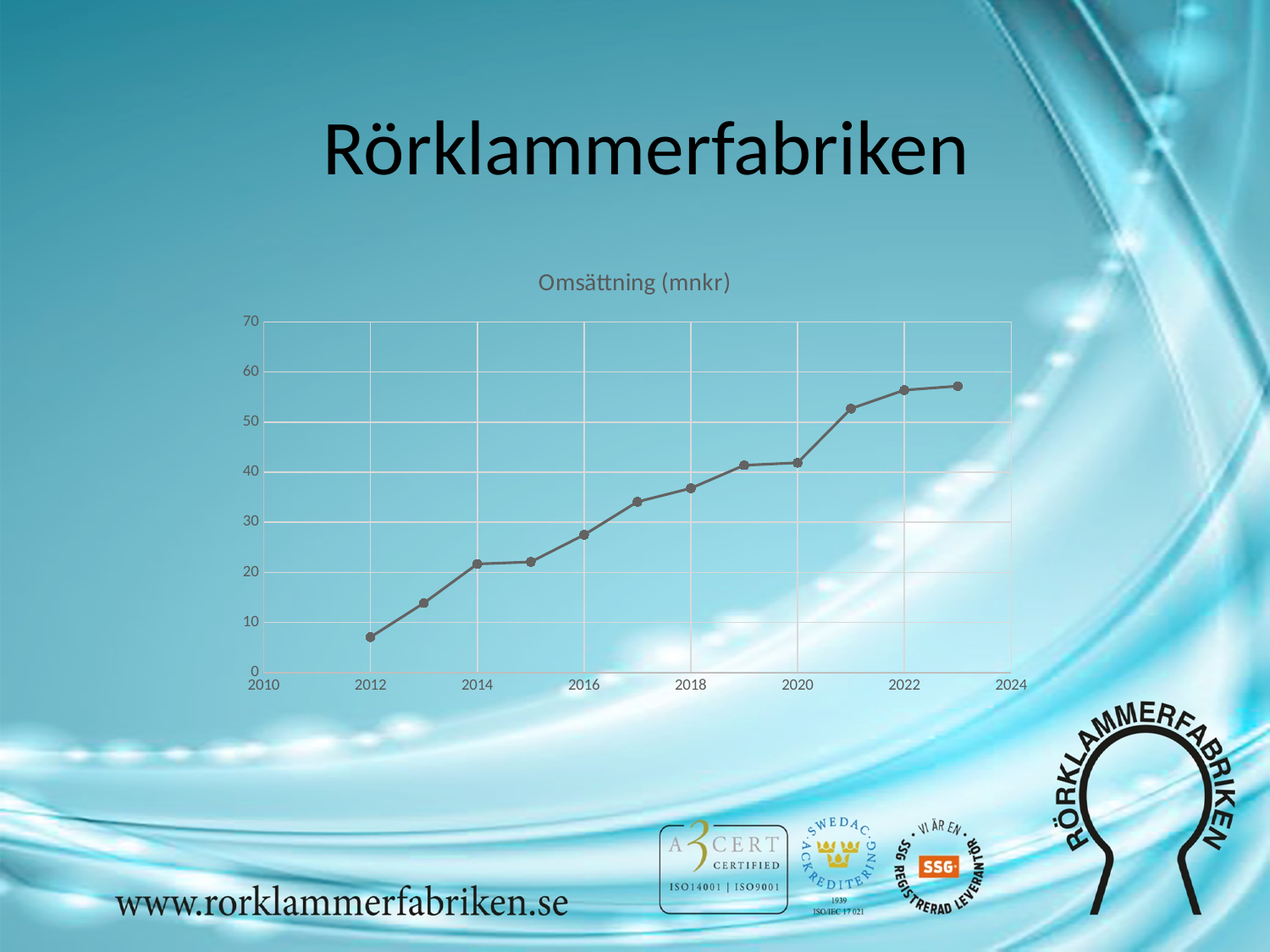
Which year has the lowest value on the chart? 2012 What is the title of the chart? Omsättning (mnkr) Which is larger, the value for 2021 or the value for 2017? 2021 What kind of chart is shown on the slide? line chart Is the value for 2023 greater or less than 60? less How many data points are plotted on the line? 12 Is the value for 2021 greater or less than 50? greater What is the highest value shown on the vertical axis? 70 Is the value for 2017 greater or less than 30? greater Do the values generally rise or fall from 2012 to 2023? rise